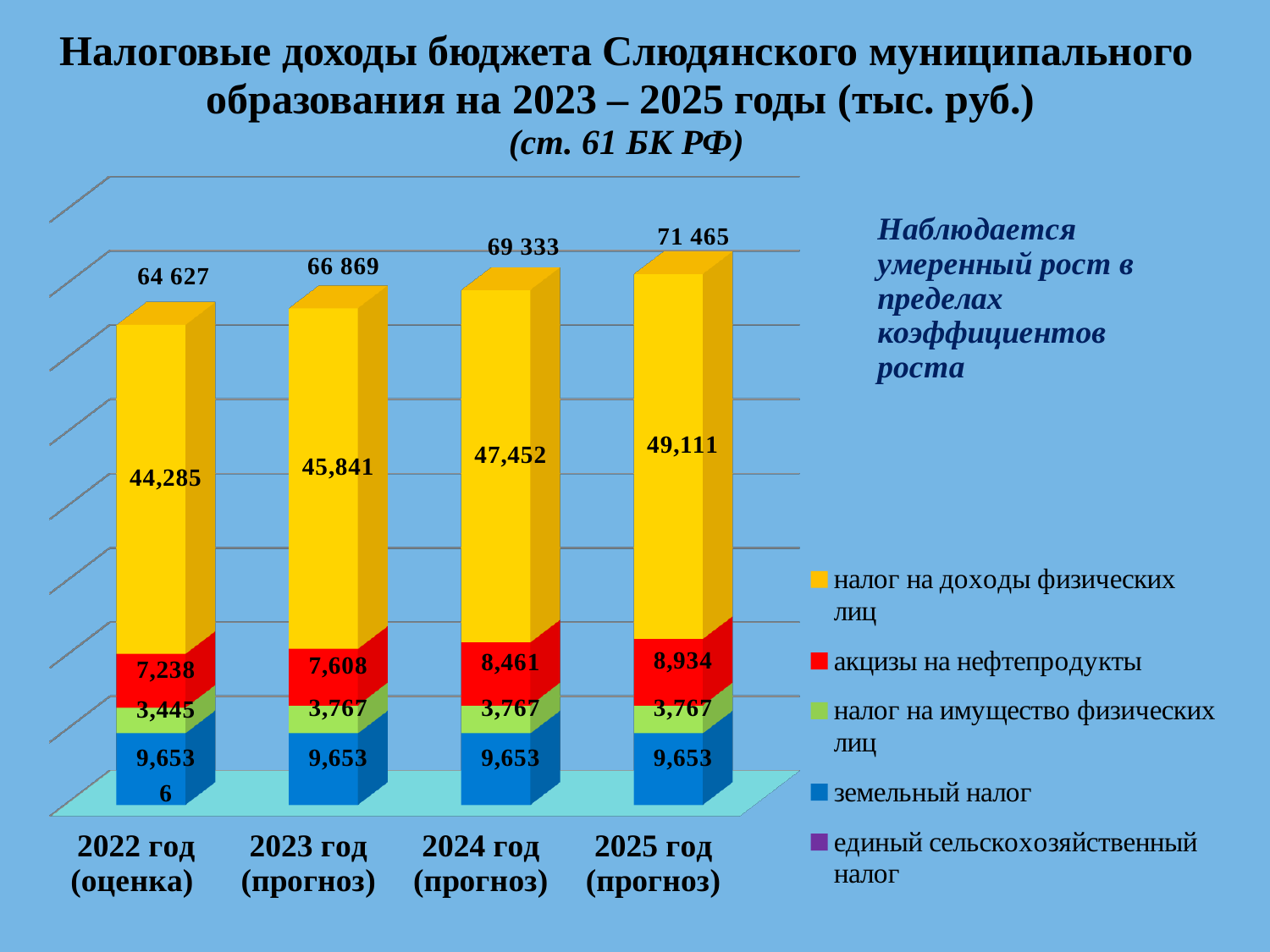
How many year categories are shown on the x axis? 4 What is the difference between the акцизы на нефтепродукты values for 2025 год (прогноз) and 2024 год (прогноз)? 473 What is the value of налог на доходы физических лиц for 2025 год (прогноз)? 49,111 How many series does the legend list? 5 Which year has the lowest value for налог на доходы физических лиц? 2022 год (оценка) What is the value of акцизы на нефтепродукты for 2023 год (прогноз)? 7,608 What total is printed above the bar for 2024 год (прогноз)? 69 333 Which year has the highest total printed above its bar? 2025 год (прогноз) What is the value of земельный налог for 2024 год (прогноз)? 9,653 Which is larger: налог на доходы физических лиц for 2023 год (прогноз) or for 2024 год (прогноз)? 2024 год (прогноз) What is the value of налог на имущество физических лиц for 2022 год (оценка)? 3,445 What kind of chart is shown on the slide? Stacked bar chart